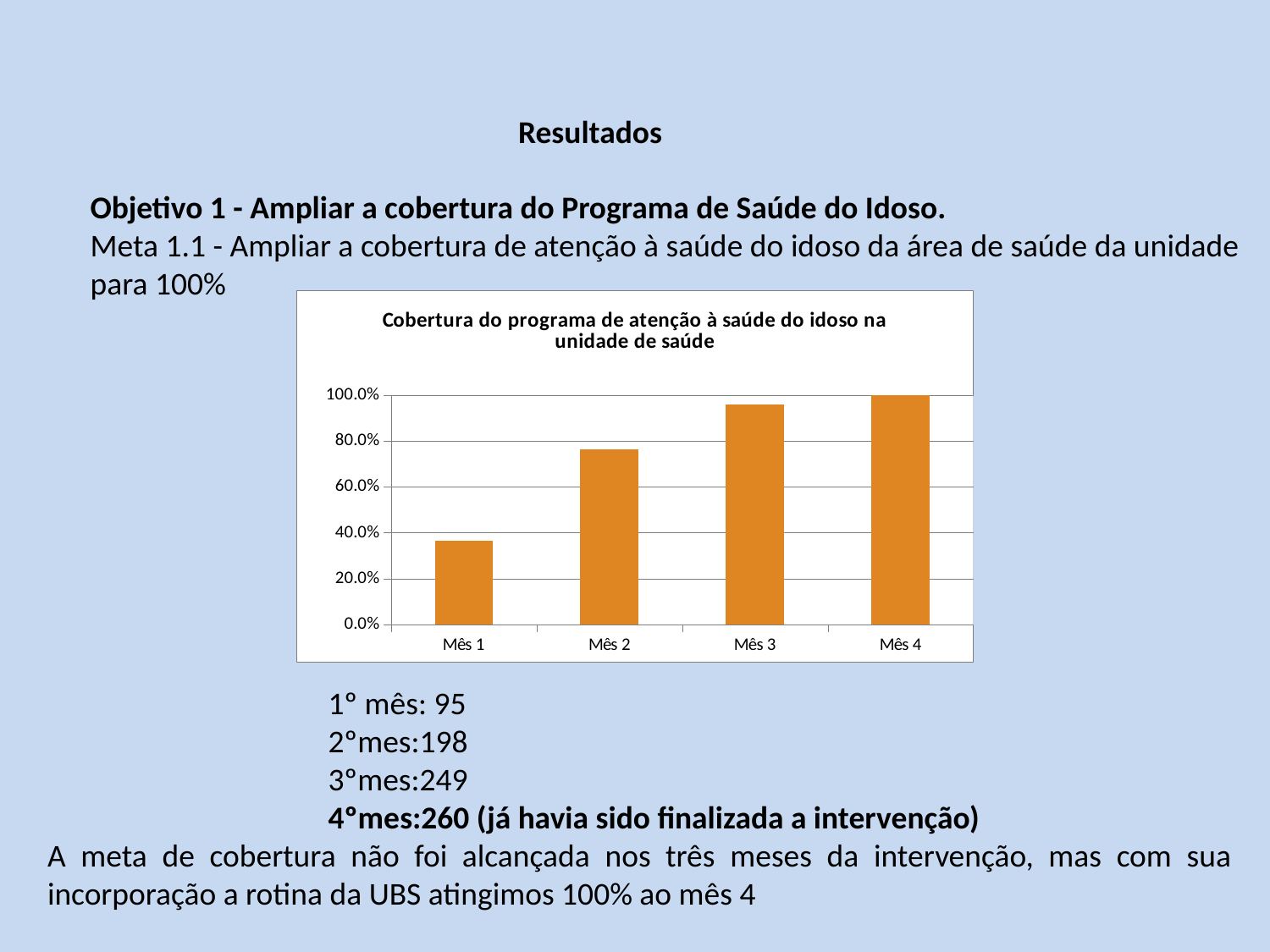
Which month has the lowest coverage in the chart? Mês 1 How many categories (months) are plotted on the x axis of the chart? 4 Is the value for Mês 3 greater or less than 80.0%? greater Do the coverage values rise or fall from Mês 1 to Mês 4? rise Is the value for Mês 1 greater or less than 40.0%? less Is the value for Mês 2 greater or less than 60.0%? greater Which month has the highest coverage in the chart? Mês 4 What kind of chart is shown on the slide? bar chart What is the title of the chart? Cobertura do programa de atenção à saúde do idoso na unidade de saúde Which is larger, the value for Mês 2 or the value for Mês 3? Mês 3